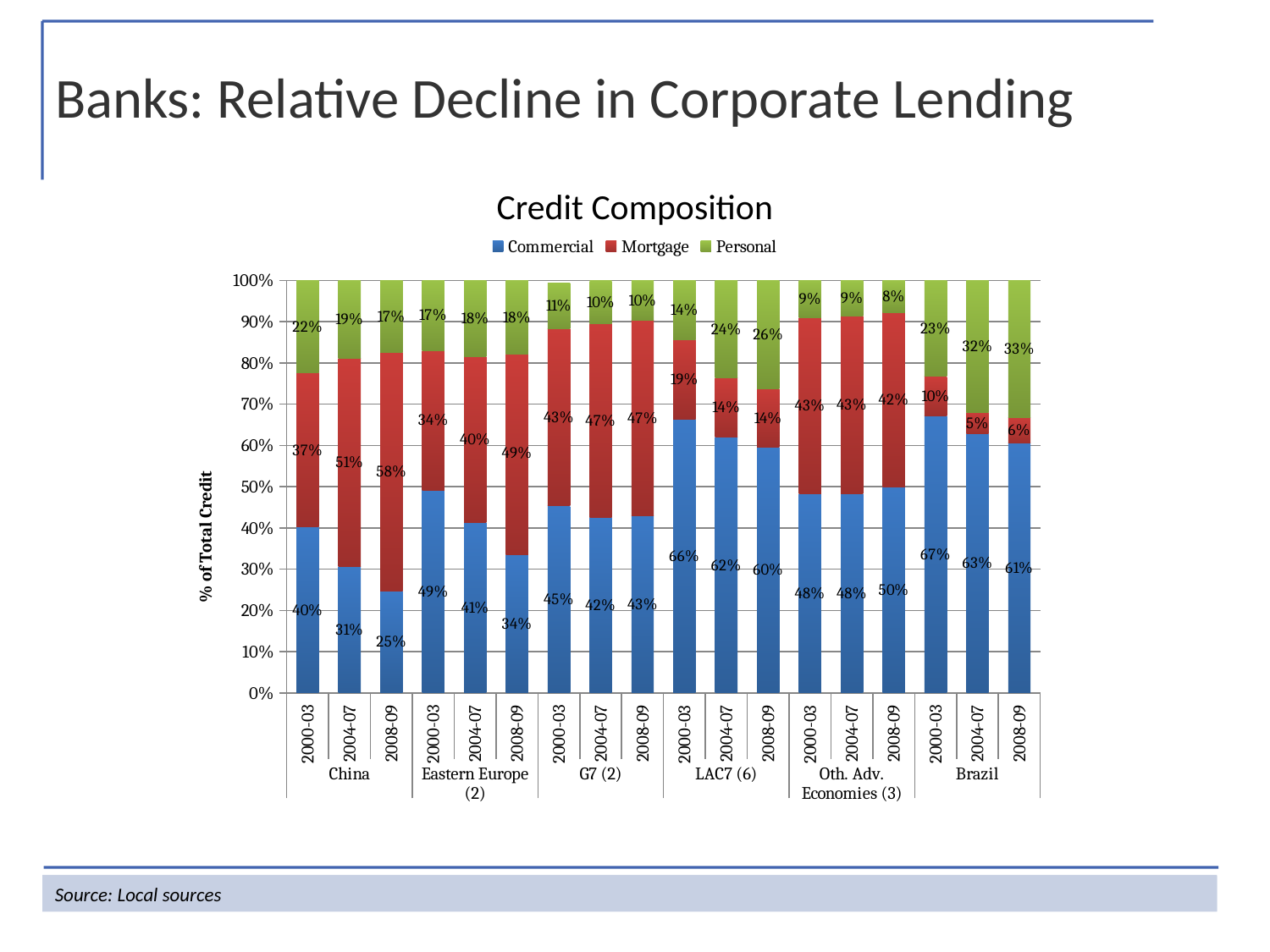
What type of chart is shown? Stacked bar chart What is the difference between the Commercial share for China in 2000-03 and in 2008-09? 15% What is the Commercial share for China in 2000-03? 40% Which region and period has the highest Commercial share? Brazil, 2000-03 Is the Mortgage share larger for Eastern Europe (2) in 2008-09 or for G7 (2) in 2008-09? Eastern Europe (2) in 2008-09 What is the Commercial share for LAC7 (6) in 2000-03? 66% What is the Mortgage share for China in 2008-09? 58% How does the Commercial share for Eastern Europe (2) change from 2000-03 to 2008-09? It falls Which region and period has the lowest Commercial share? China, 2008-09 What is the Personal share for Brazil in 2008-09? 33% How many bars are plotted in the chart? 18 How many series does the legend list? 3